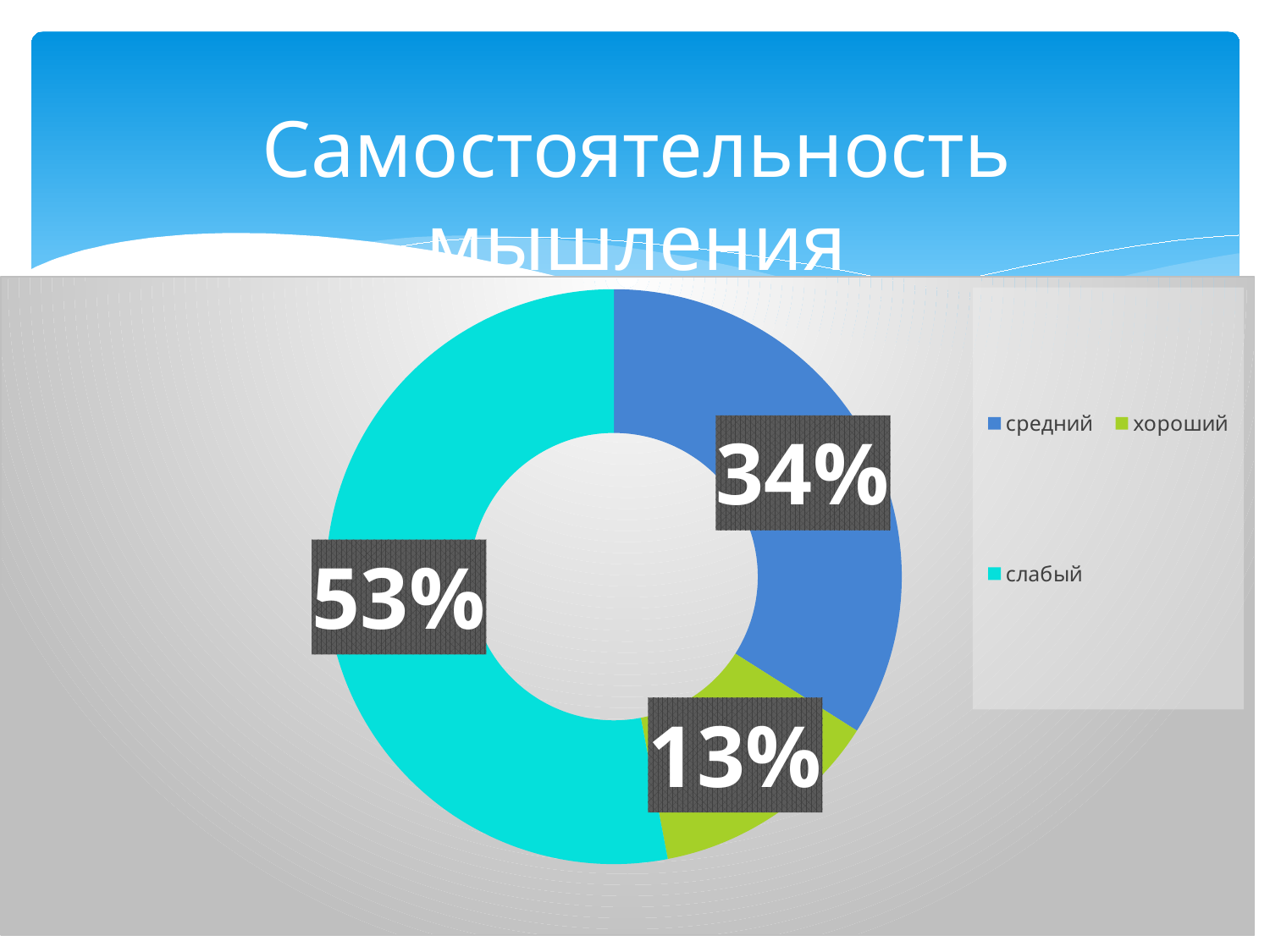
How many categories are shown in the chart? 3 Which is larger, the share for средний or the share for хороший? средний What percentage does the слабый category represent? 53% What colour represents the слабый category? cyan Which category has the smallest share? хороший What is the difference in percentage points between средний and хороший? 21 Which category has the largest share? слабый What percentage does the средний category represent? 34% What percentage does the хороший category represent? 13% What is the difference in percentage points between слабый and средний? 19 What kind of chart is shown on the slide? doughnut chart What is the title of the slide? Самостоятельность мышления